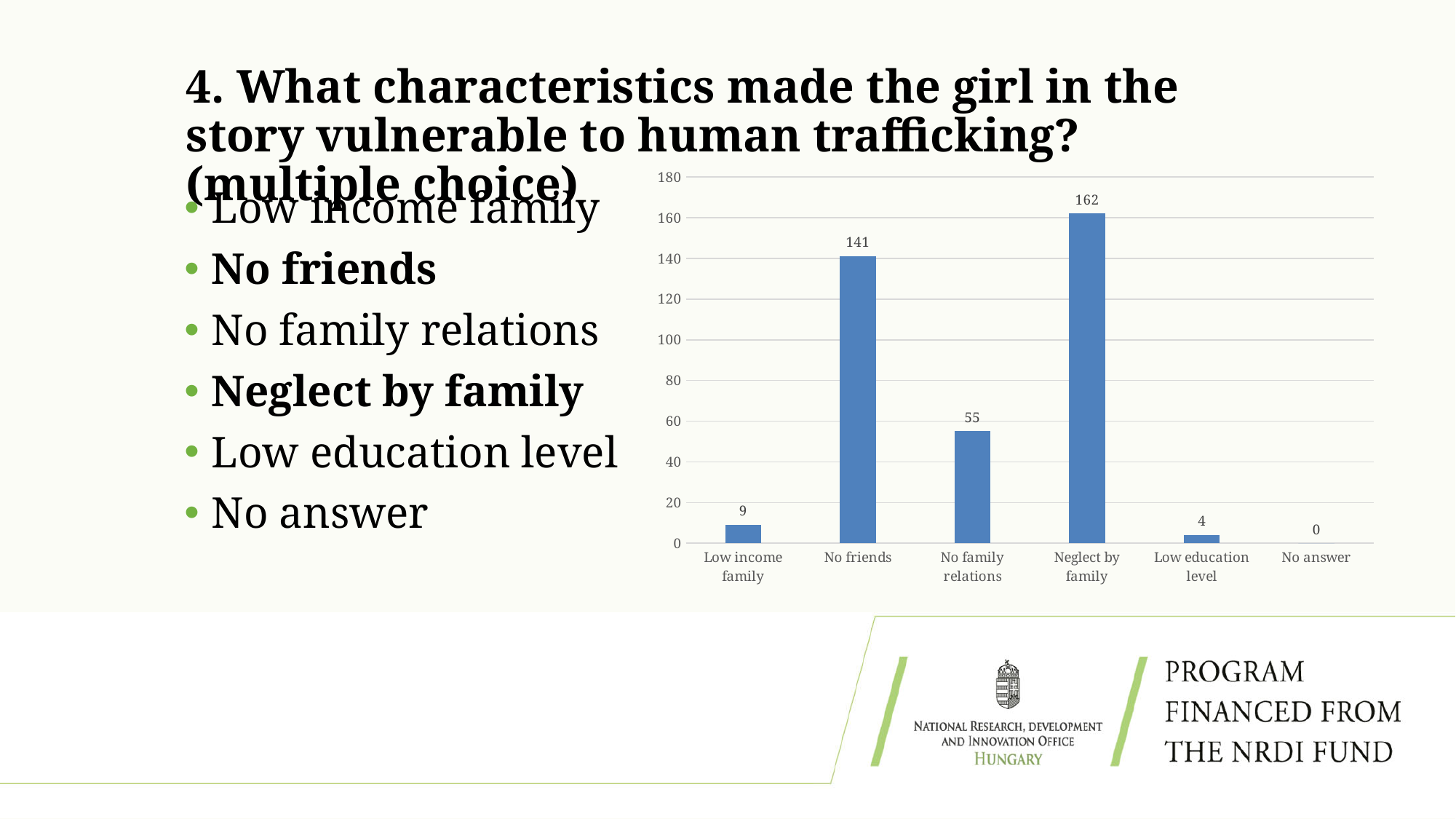
What is the value for Neglect by family? 162 Which is larger, the value for No family relations or the value for Low education level? No family relations What is the value for No friends? 141 What is the value for No family relations? 55 Is the value for No friends greater or less than 120? greater What is the value for Low income family? 9 What is the difference between the values for Neglect by family and No friends? 21 Which category has the highest value? Neglect by family What kind of chart is shown on the slide? bar chart How many categories are shown on the x axis? 6 What is the value for No answer? 0 Which category has the lowest value? No answer